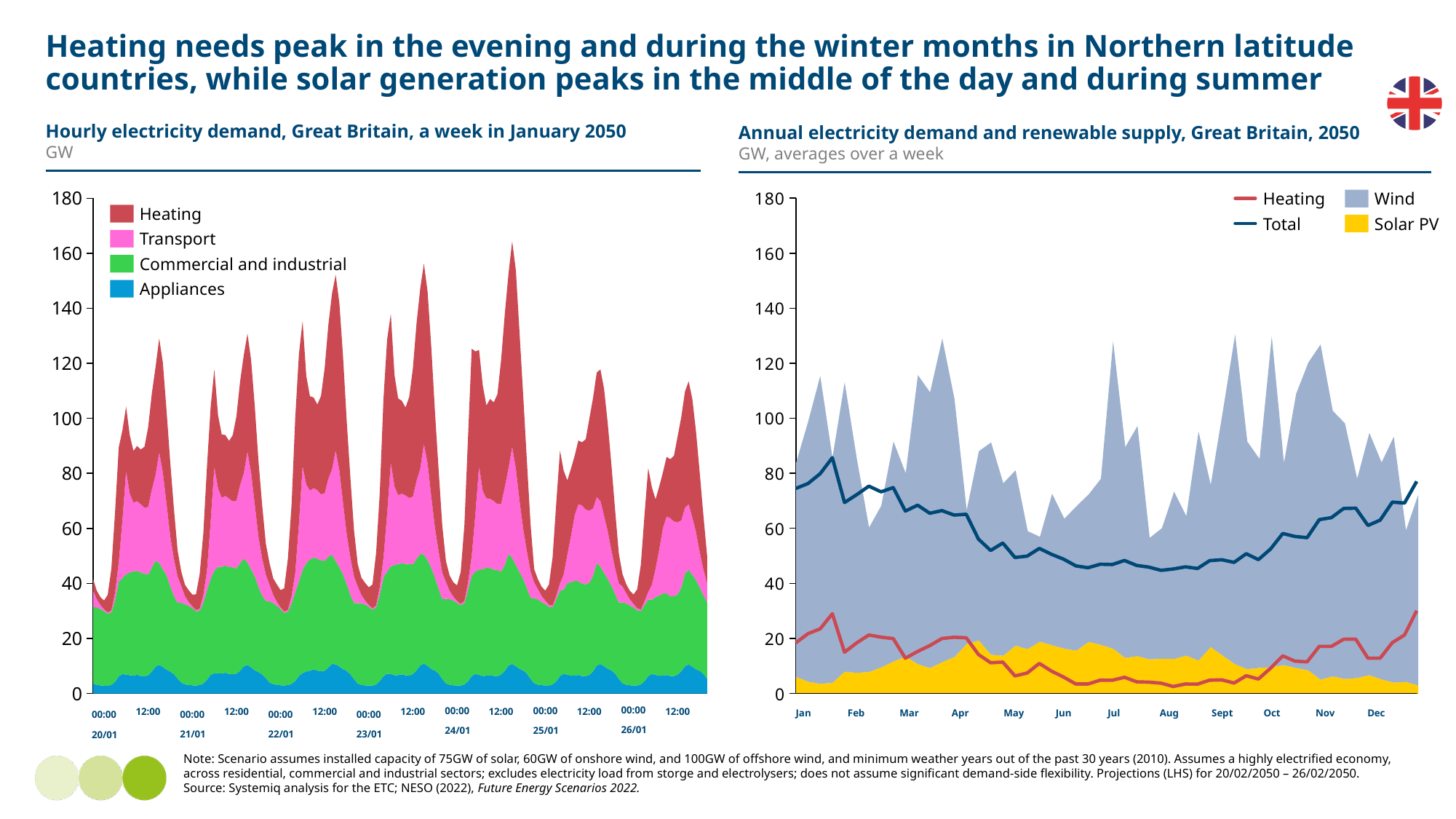
In the left chart (hourly electricity demand), is the peak total demand on 22/01 greater or less than 140? greater In the left chart (hourly electricity demand), which series is at the bottom of the stack? Appliances In the left chart (hourly electricity demand), how many days are labelled along the x axis? 7 In the right chart (annual electricity demand and renewable supply), is the Total line higher in Jan or in Jul? Jan In the right chart (annual electricity demand and renewable supply), is the Total line in Jan greater or less than 60? greater How many series does the legend of the right chart (annual electricity demand and renewable supply) list? 4 In the right chart (annual electricity demand and renewable supply), is the Heating line in Aug greater or less than 20? less How many series does the legend of the left chart (hourly electricity demand) list? 4 In the right chart (annual electricity demand and renewable supply), does the Total line rise or fall from Jan to Aug? Fall In the right chart (annual electricity demand and renewable supply), how many months are labelled along the x axis? 12 What kind of chart is the left chart, 'Hourly electricity demand, Great Britain, a week in January 2050'? Stacked area chart